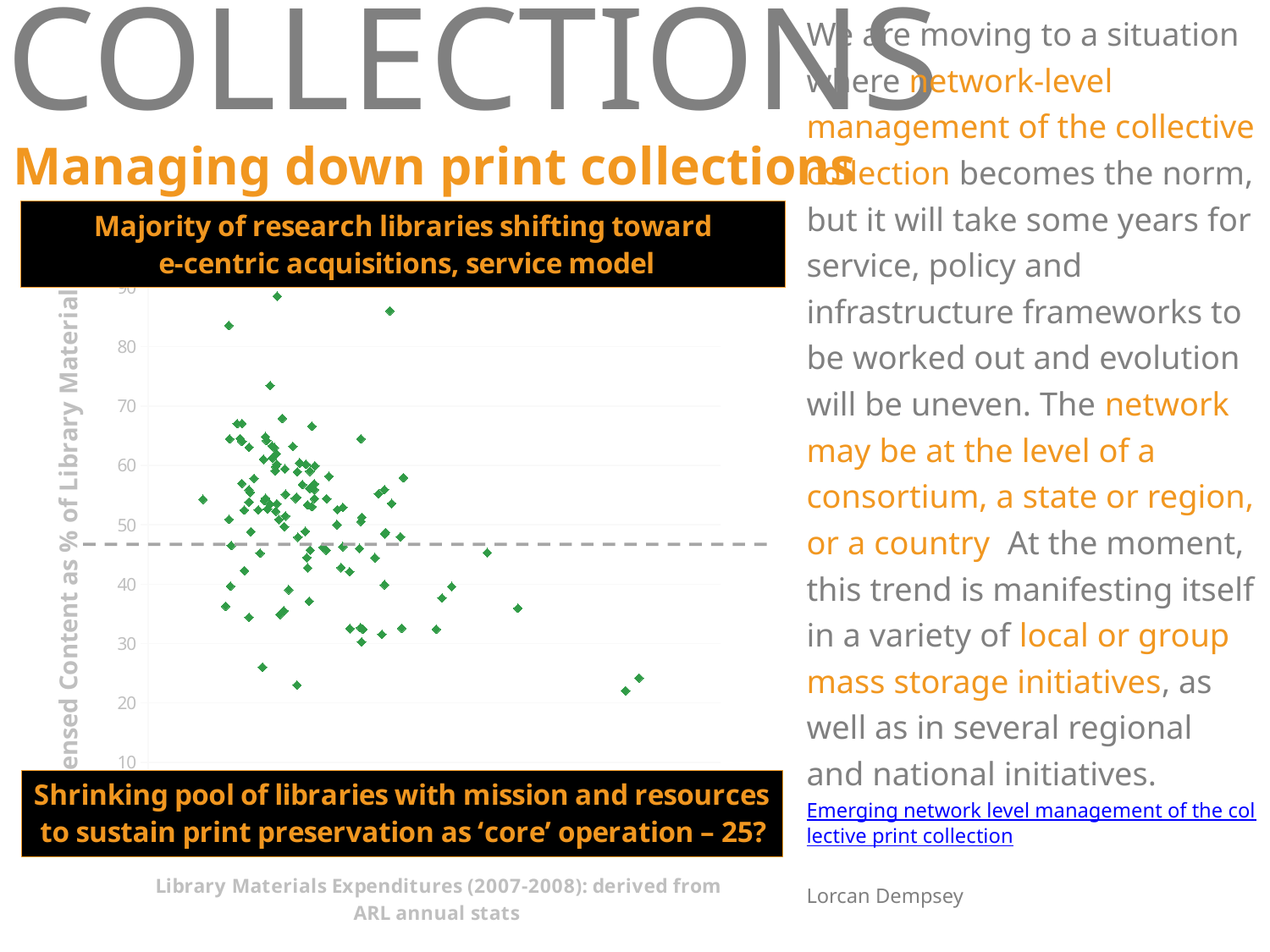
What is the lowest tick value shown on the vertical axis of the chart? 10 Is the highest plotted point in the scatter chart greater or less than 80? greater What kind of chart is shown on the slide? scatter chart What is the highest tick value shown on the vertical axis of the chart? 90 What is the title printed beneath the chart? Library Materials Expenditures (2007-2008): derived from ARL annual stats Is the dashed horizontal line in the chart above or below the 50 tick on the vertical axis? below Is the lowest plotted point in the scatter chart greater or less than 30? less